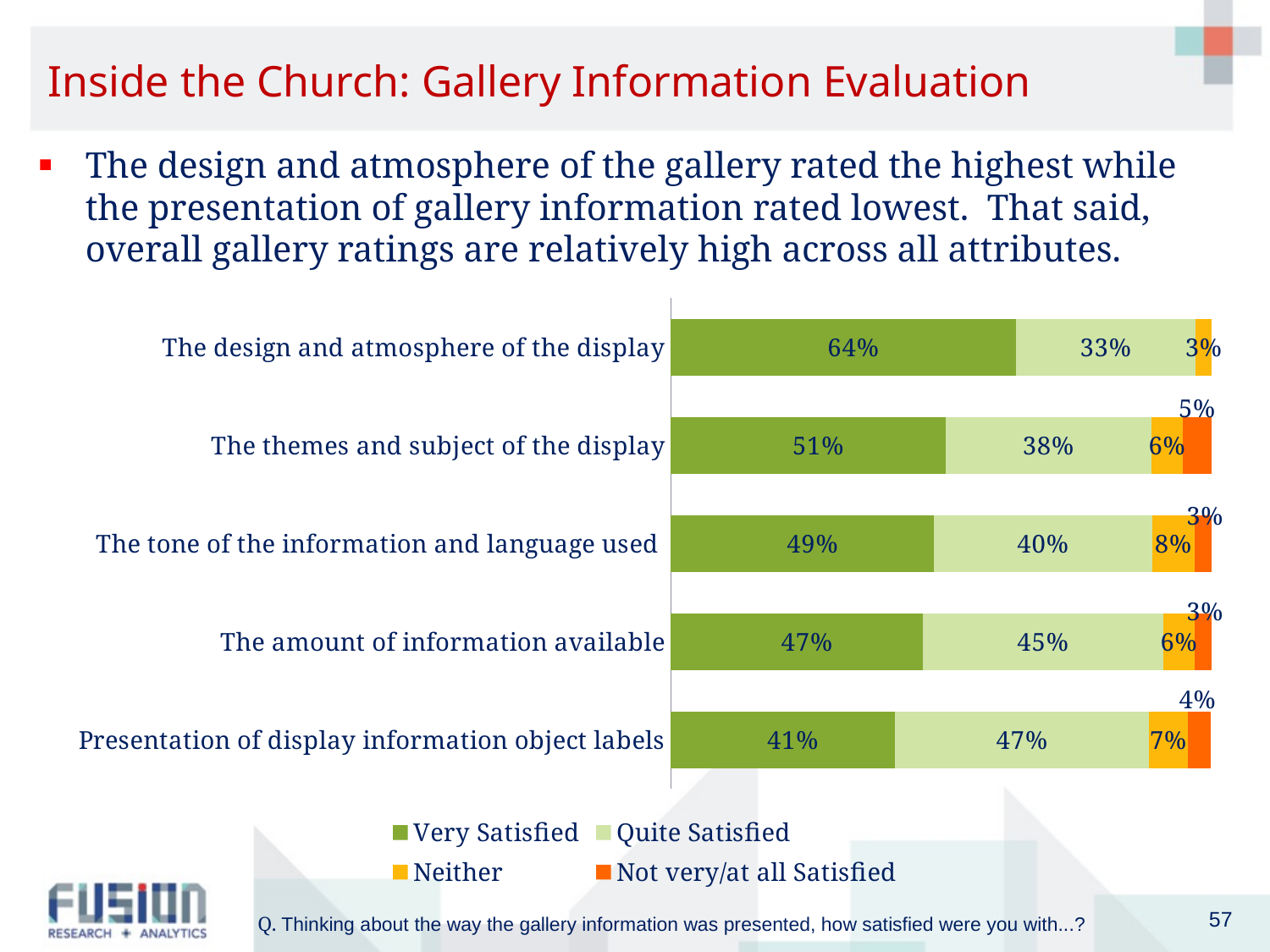
What kind of chart is shown on the slide? Stacked bar chart What percentage were Quite Satisfied with the amount of information available? 45% What is the difference between the Very Satisfied percentages for the design and atmosphere of the display and the presentation of display information object labels? 23 percentage points Which attribute has the lowest Very Satisfied percentage? Presentation of display information object labels What percentage of respondents were Very Satisfied with the design and atmosphere of the display? 64% What is the Neither value for the tone of the information and language used? 8% Which attribute has the highest Very Satisfied percentage? The design and atmosphere of the display Which is larger for the presentation of display information object labels: the Very Satisfied or the Quite Satisfied percentage? Quite Satisfied How many attributes are shown in the chart? 5 How many series does the legend list? 4 What is the combined total of the Very Satisfied and Quite Satisfied percentages for the themes and subject of the display? 89% What is the Not very/at all Satisfied value for the themes and subject of the display? 5%